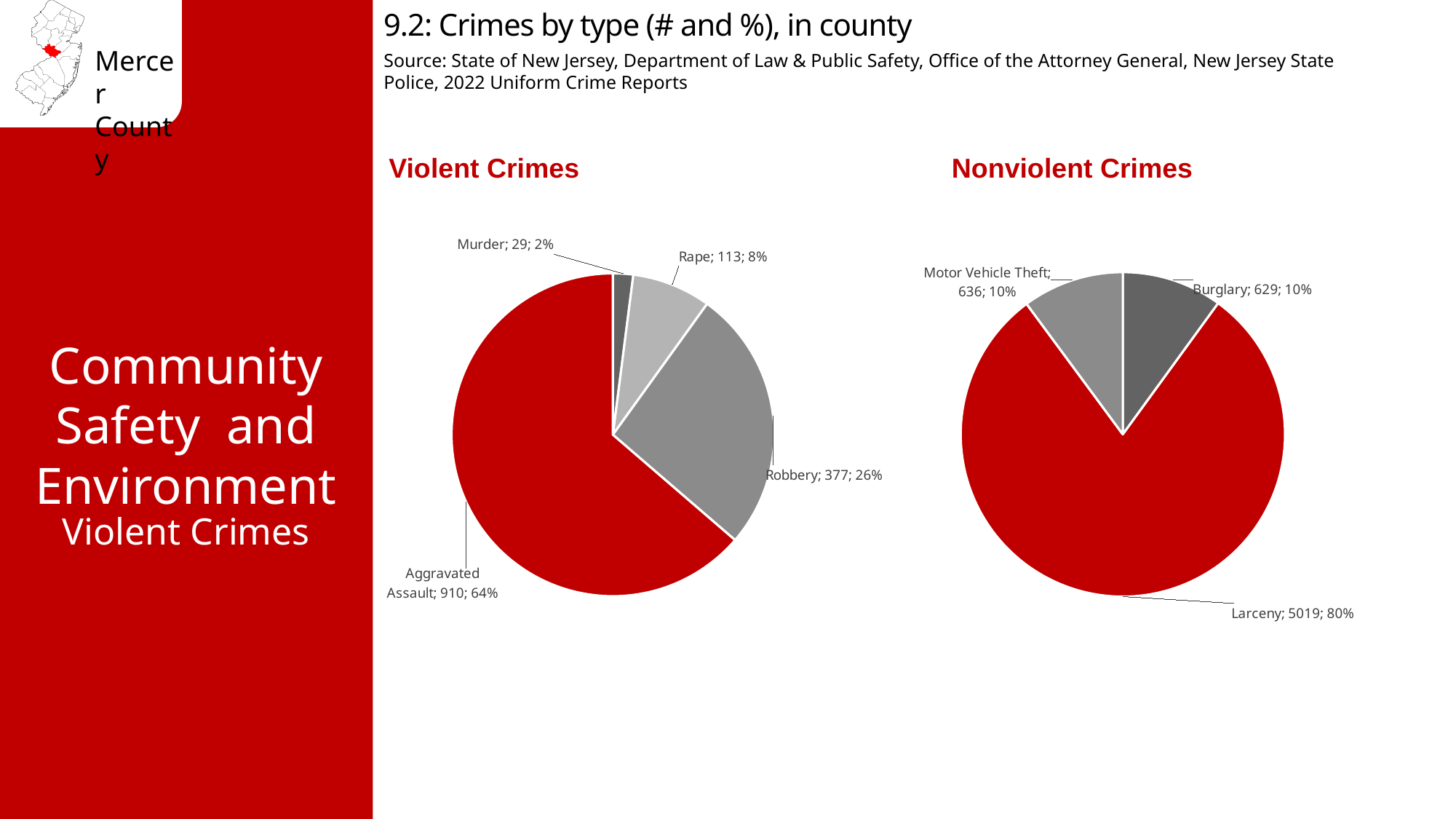
In the Violent Crimes chart, which category has the largest slice? Aggravated Assault In the Violent Crimes chart, what is the difference between the number of robberies and the number of rapes? 264 What type of chart is used for the Nonviolent Crimes chart? Pie chart In the Violent Crimes chart, how many categories are shown? 4 In the Nonviolent Crimes chart, which is larger in count, Motor Vehicle Theft or Burglary? Motor Vehicle Theft In the Violent Crimes chart, what percentage of violent crimes is robbery? 26% In the Nonviolent Crimes chart, how many larcenies are shown? 5019 In the Nonviolent Crimes chart, what is the total number of nonviolent crimes across all three categories? 6284 In the Nonviolent Crimes chart, what percentage of nonviolent crimes is motor vehicle theft? 10% In the Violent Crimes chart, how many aggravated assaults are shown? 910 In the Violent Crimes chart, which category has the smallest slice? Murder In the Nonviolent Crimes chart, what colour is the Larceny slice? Red